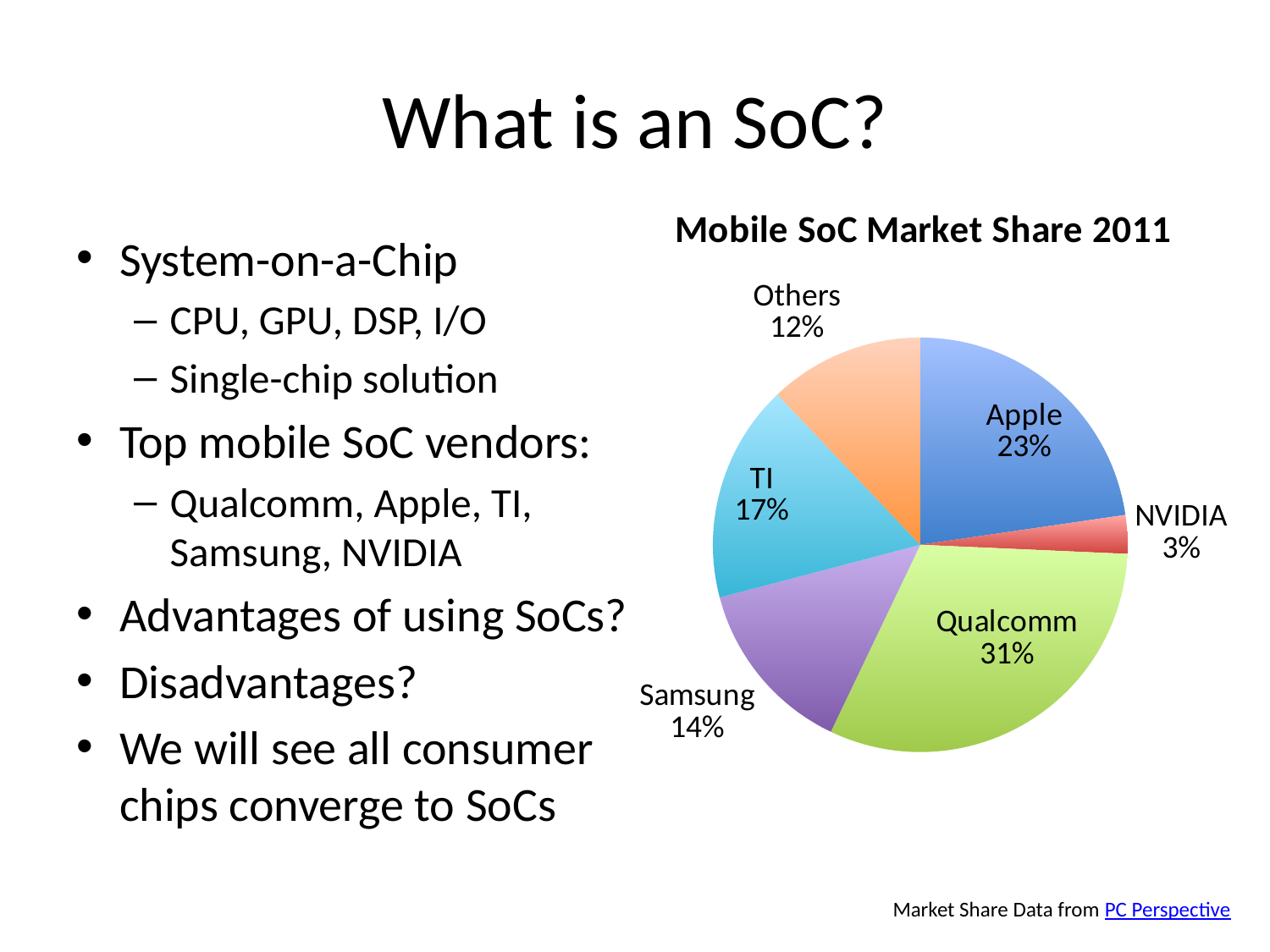
Which vendor has the largest slice of the pie? Qualcomm What is the market share shown for Qualcomm? 31% How many slices does the pie chart have? 6 What is the market share shown for TI? 17% What is the market share shown for NVIDIA? 3% Which vendor has the smallest slice of the pie? NVIDIA Which has a larger market share, TI or Samsung? TI What is the difference in market share between Qualcomm and Apple? 8% What kind of chart is shown on the slide? Pie chart What is the market share shown for Apple? 23% What is the combined market share of Samsung and Others? 26% What is the title of the chart? Mobile SoC Market Share 2011